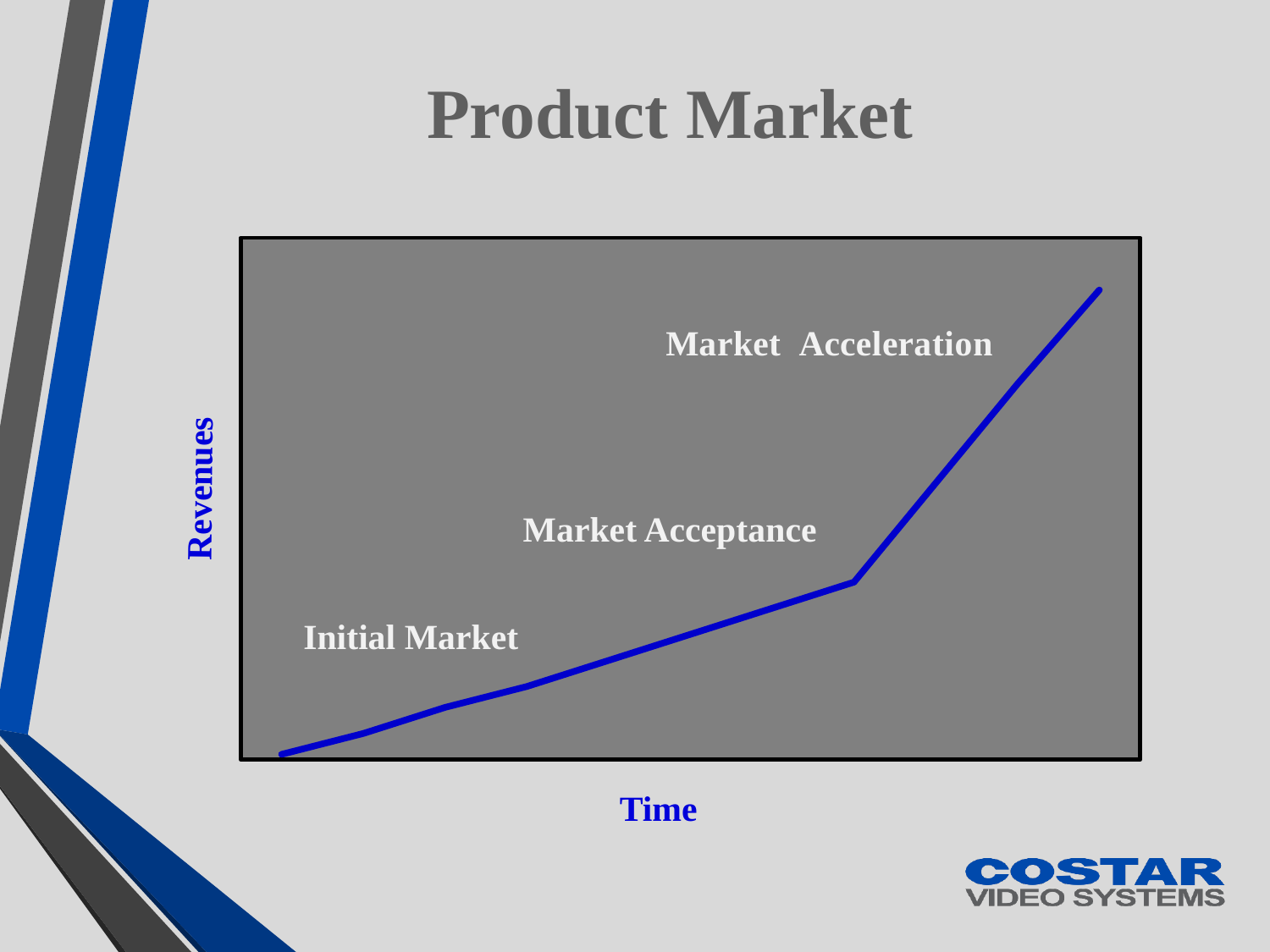
How many lines are plotted on the chart? 1 What is the label on the vertical axis of the chart? Revenues Which labelled phase comes first along the time axis? Initial Market What is the label on the horizontal axis of the chart? Time What kind of chart is shown on the slide? Line chart Which labelled phase lies between Initial Market and Market Acceleration? Market Acceptance In which labelled phase does the line rise most steeply? Market Acceleration Are revenues higher in the Market Acceleration phase or the Initial Market phase? Market Acceleration Which labelled phase comes last along the time axis? Market Acceleration Do revenues rise or fall over time in the chart? Rise How many market phases are labelled on the chart? 3